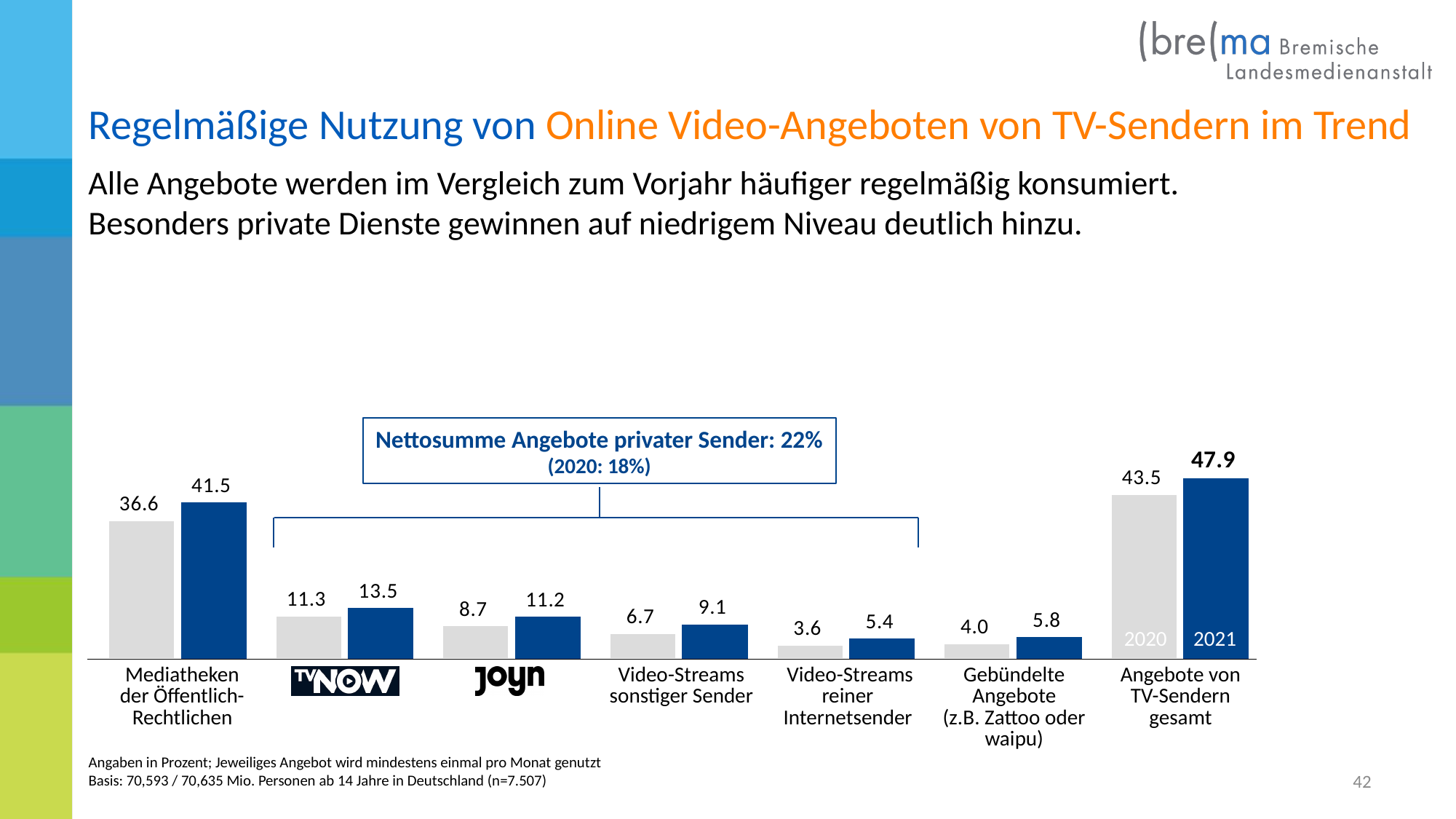
Which is larger: the 2021 value for Joyn or the 2021 value for Video-Streams sonstiger Sender? Joyn Which category has the lowest 2020 value? Video-Streams reiner Internetsender What is the 2021 value for Mediatheken der Öffentlich-Rechtlichen? 41.5 What kind of chart is shown on the slide? Bar chart Which category has the highest 2021 value? Angebote von TV-Sendern gesamt What is the Nettosumme Angebote privater Sender stated in the box above the chart? 22% How many series does the chart show? 2 How many categories are shown on the x axis? 7 What is the 2020 value for Angebote von TV-Sendern gesamt? 43.5 What is the 2021 value for Video-Streams reiner Internetsender? 5.4 What is the difference between the 2021 and 2020 values for TV NOW? 2.2 What is the 2020 value for Joyn? 8.7